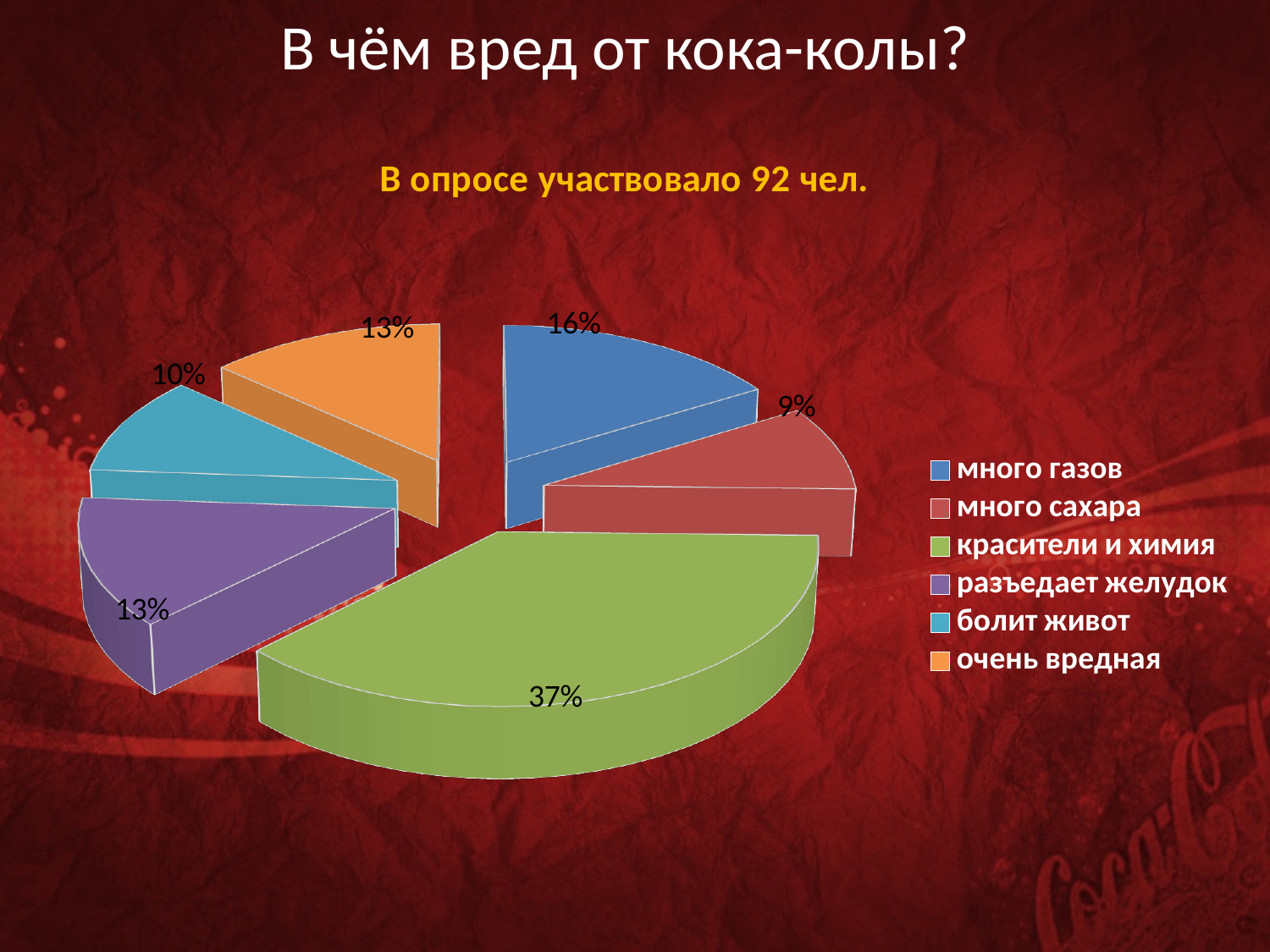
How many people took part in the survey according to the slide? 92 How many categories does the pie chart have? 6 Which category has the smallest slice of the pie? много сахара What share of the pie does "много газов" have? 16% What is the difference between the shares of "красители и химия" and "много газов"? 21% Which is larger, the share for "много газов" or the share for "болит живот"? много газов Which colour represents "очень вредная" in the legend? orange Which category has the largest slice of the pie? красители и химия What share of the pie does "много сахара" have? 9% What share of the pie does "болит живот" have? 10% What kind of chart is shown on the slide? pie chart